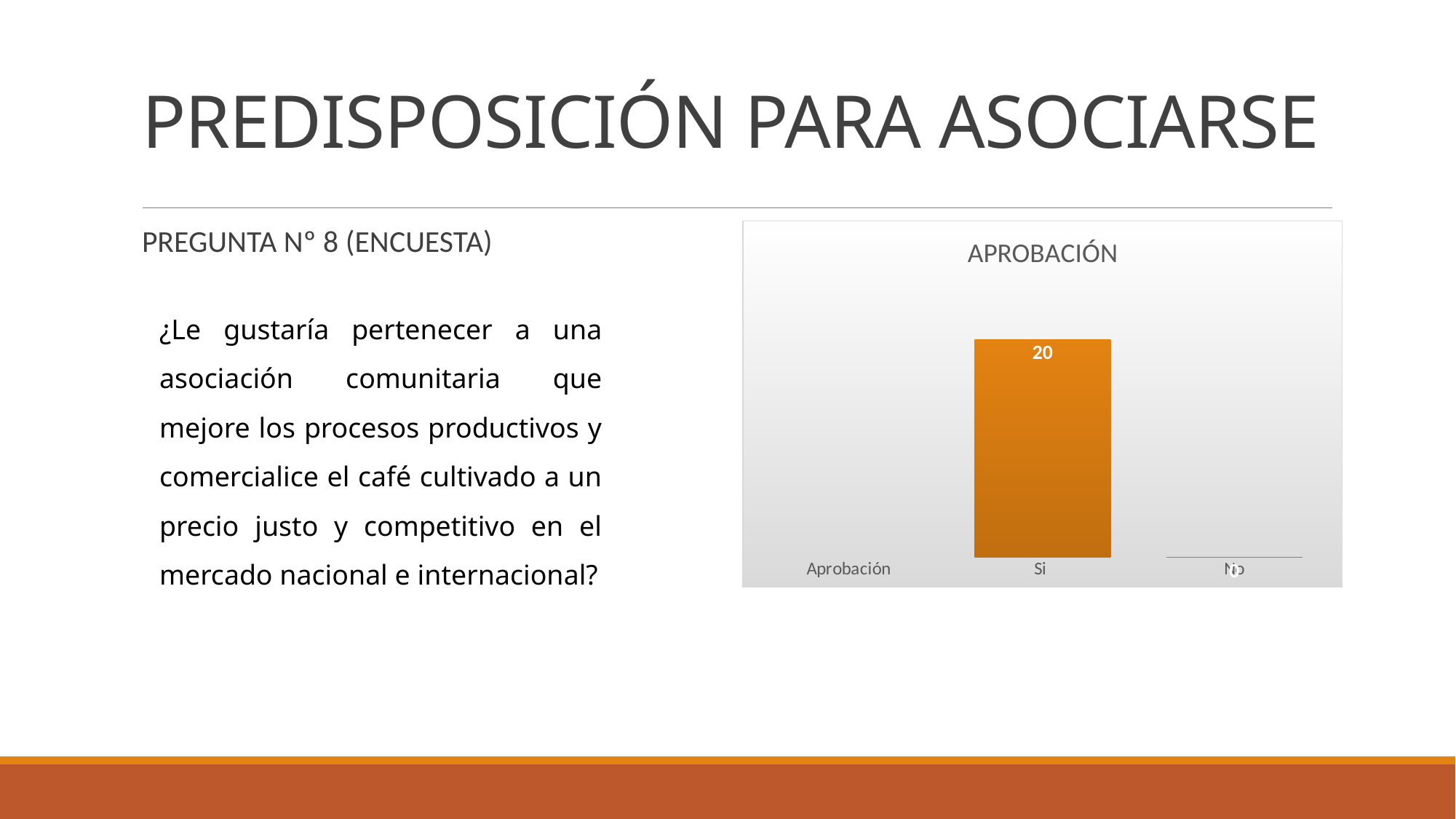
Which is larger in the APROBACIÓN chart, Si or No? Si What is the value for Si in the APROBACIÓN chart? 20 What kind of chart is shown on the slide? bar chart How many categories are shown on the x axis of the APROBACIÓN chart? 3 What colour is the bar for Si in the APROBACIÓN chart? orange Which category has the highest value in the APROBACIÓN chart? Si What is the title of the chart? APROBACIÓN